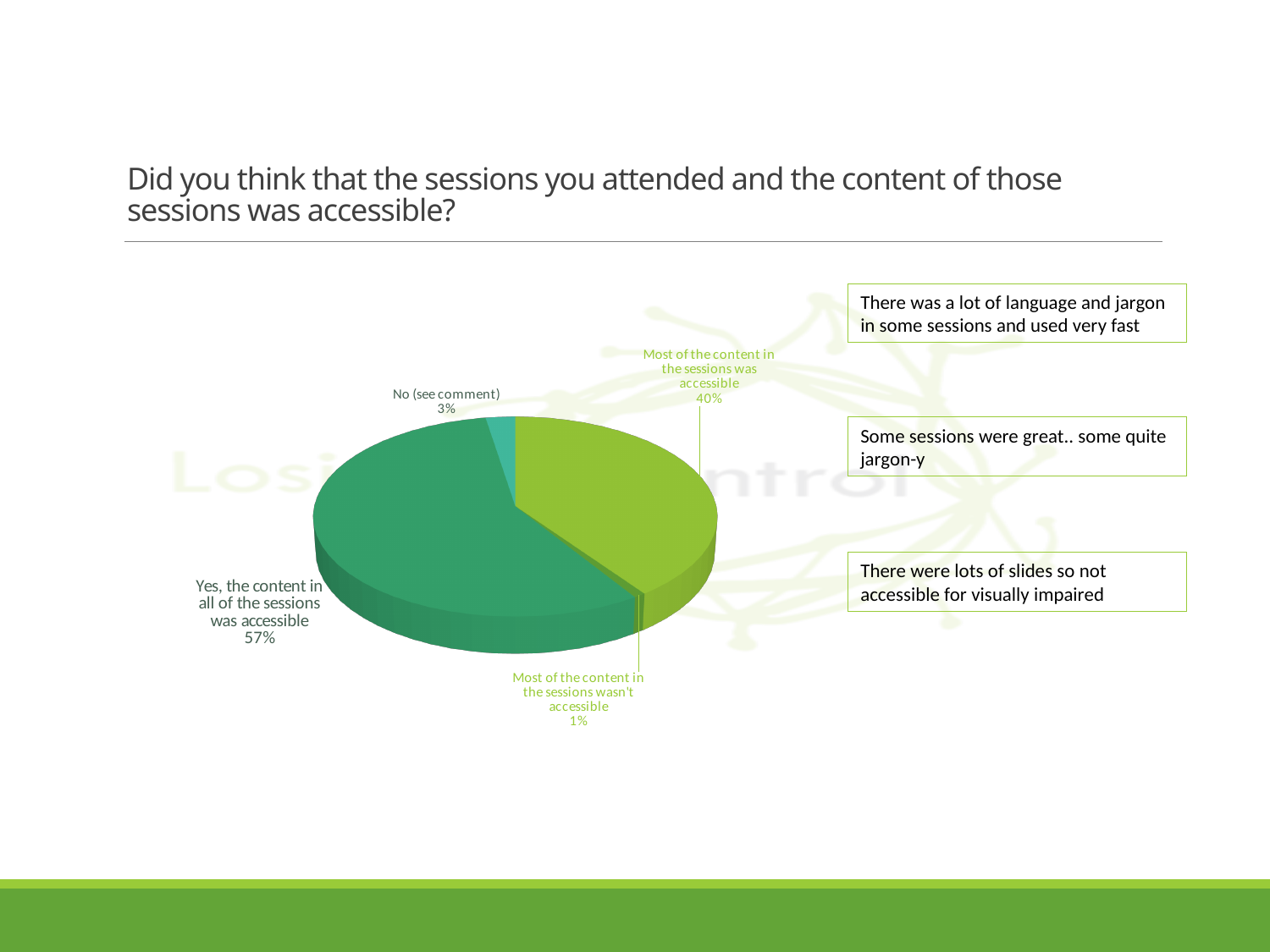
What share of the pie is 'Yes, the content in all of the sessions was accessible'? 57% What kind of chart is shown on the slide? Pie chart What is the difference in percentage points between 'Yes, the content in all of the sessions was accessible' and 'Most of the content in the sessions was accessible'? 17 percentage points What question is the pie chart answering, according to the slide title? Did you think that the sessions you attended and the content of those sessions was accessible? How many slices does the pie chart have? 4 Which is larger: the share for 'No (see comment)' or the share for 'Most of the content in the sessions wasn't accessible'? No (see comment) Which response has the largest share of the pie? Yes, the content in all of the sessions was accessible What share of the pie is 'Most of the content in the sessions was accessible'? 40% What share of the pie is 'Most of the content in the sessions wasn't accessible'? 1% Which response has the smallest share of the pie? Most of the content in the sessions wasn't accessible What is the combined share of 'No (see comment)' and 'Most of the content in the sessions wasn't accessible'? 4%